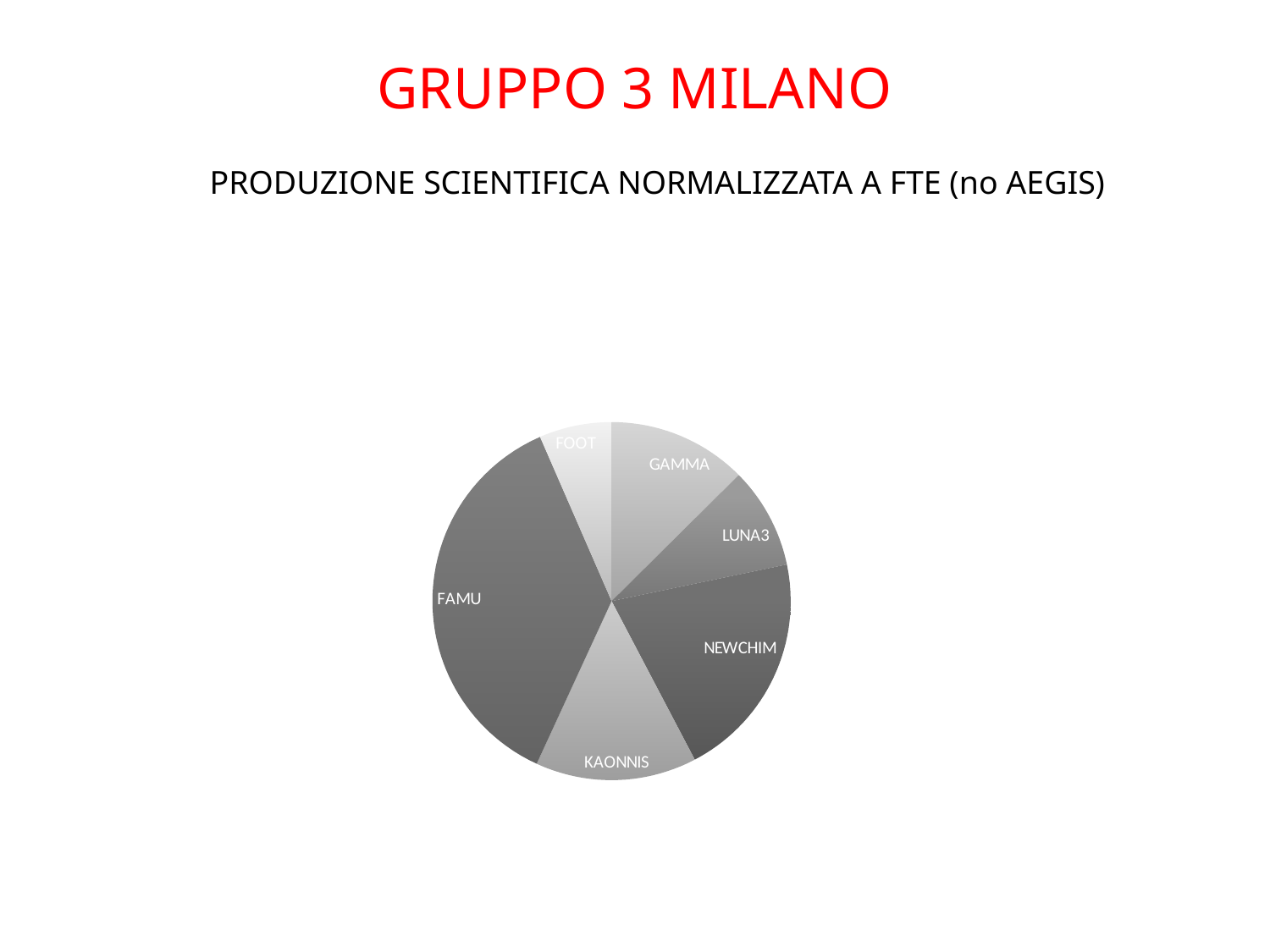
Which slice is larger, FAMU or KAONNIS? FAMU Which slice of the pie chart is the smallest? FOOT What kind of chart is shown on the slide? pie chart Which slice is larger, GAMMA or FOOT? GAMMA Which slice is larger, NEWCHIM or FOOT? NEWCHIM What is the title of the pie chart? PRODUZIONE SCIENTIFICA NORMALIZZATA A FTE (no AEGIS) Which group is named in the slide heading above the chart? GRUPPO 3 MILANO How many slices does the pie chart have? 6 Which slice of the pie chart is the largest? FAMU